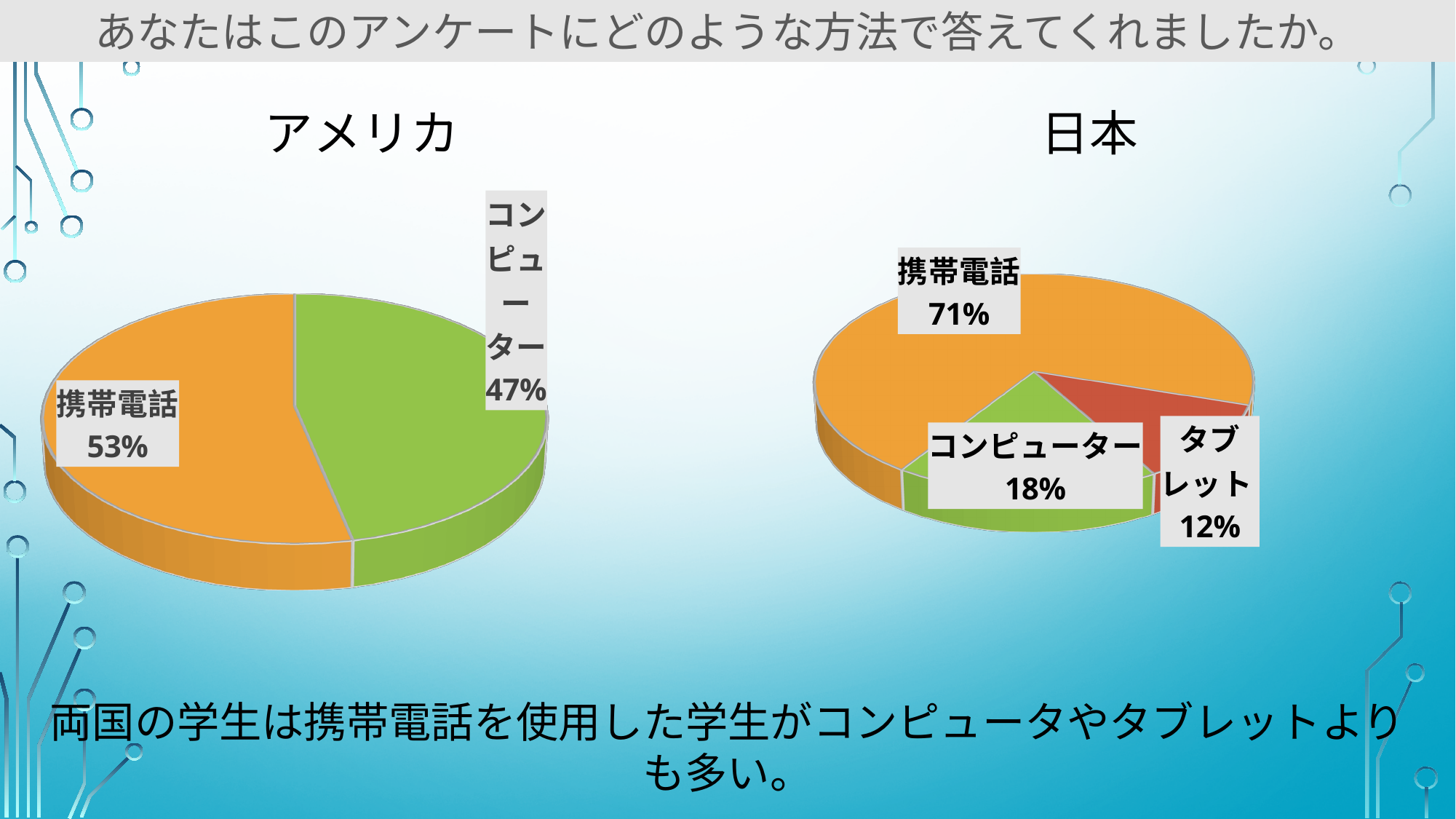
In the 日本 pie chart, what percentage is shown for タブレット? 12% In the 日本 pie chart, which category has the largest share? 携帯電話 In the 日本 pie chart, what percentage is shown for 携帯電話? 71% In the アメリカ pie chart, what percentage is shown for コンピューター? 47% What type of chart is used for アメリカ? Pie chart In the アメリカ pie chart, what is the difference in percentage points between 携帯電話 and コンピューター? 6 In the アメリカ pie chart, which is larger, 携帯電話 or コンピューター? 携帯電話 In the 日本 pie chart, which category has the smallest share? タブレット In the アメリカ pie chart, what percentage is shown for 携帯電話? 53% How many slices does the 日本 pie chart have? 3 In the 日本 pie chart, what percentage is shown for コンピューター? 18% In the 日本 pie chart, what is the difference in percentage points between 携帯電話 and コンピューター? 53